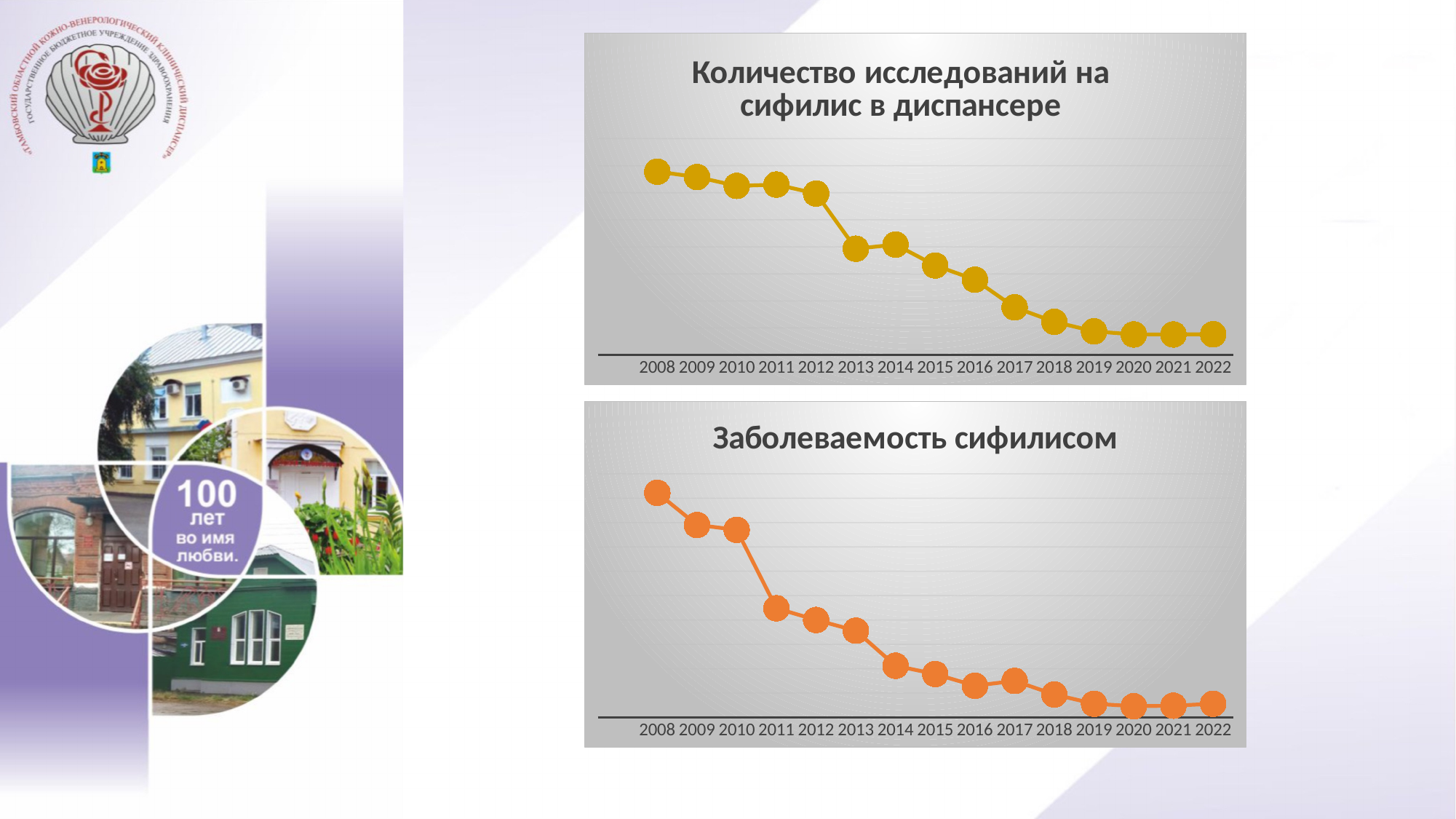
What is the first year shown on the x axis of the bottom chart "Заболеваемость сифилисом"? 2008 In the bottom chart "Заболеваемость сифилисом", how many data points are plotted? 15 What kind of chart is the top chart titled "Количество исследований на сифилис в диспансере"? line chart In the top chart "Количество исследований на сифилис в диспансере", which is larger, the value for 2012 or the value for 2013? 2012 What is the title of the top chart on the slide? Количество исследований на сифилис в диспансере In the top chart "Количество исследований на сифилис в диспансере", do the values rise or fall from 2008 to 2022? fall In the top chart "Количество исследований на сифилис в диспансере", which year has the highest value? 2008 What kind of chart is the bottom chart titled "Заболеваемость сифилисом"? line chart In the bottom chart "Заболеваемость сифилисом", do the values rise or fall over the period shown? fall In the bottom chart "Заболеваемость сифилисом", which year has the highest value? 2008 In the bottom chart "Заболеваемость сифилисом", which is larger, the value for 2010 or the value for 2011? 2010 In the top chart "Количество исследований на сифилис в диспансере", how many years are shown on the x axis? 15